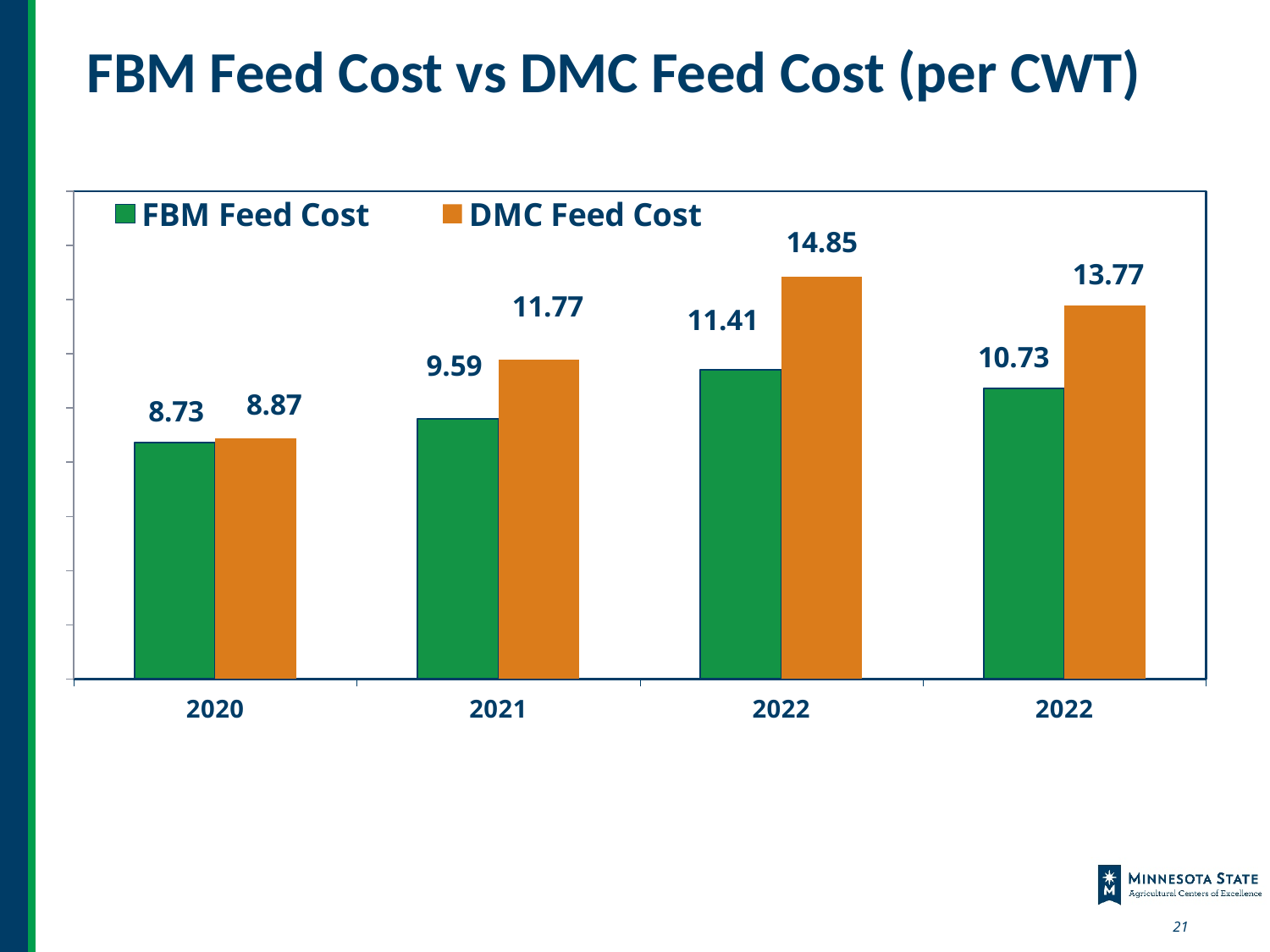
Which group of bars has the highest DMC Feed Cost? The third group (first 2022) Which year has the lowest FBM Feed Cost? 2020 What is the difference between the DMC Feed Cost and the FBM Feed Cost in the third group of bars (the first 2022 group)? 3.44 What type of chart is shown on the slide? Bar chart How many series does the legend list? 2 What is the difference between the DMC Feed Cost and the FBM Feed Cost in 2021? 2.18 How many groups of bars are shown on the x axis? 4 What is the FBM Feed Cost in the fourth group of bars (the second 2022 group)? 10.73 What is the DMC Feed Cost in the third group of bars (the first 2022 group)? 14.85 In 2020, which is larger, the FBM Feed Cost or the DMC Feed Cost? DMC Feed Cost What is the FBM Feed Cost for 2020? 8.73 What is the DMC Feed Cost for 2021? 11.77